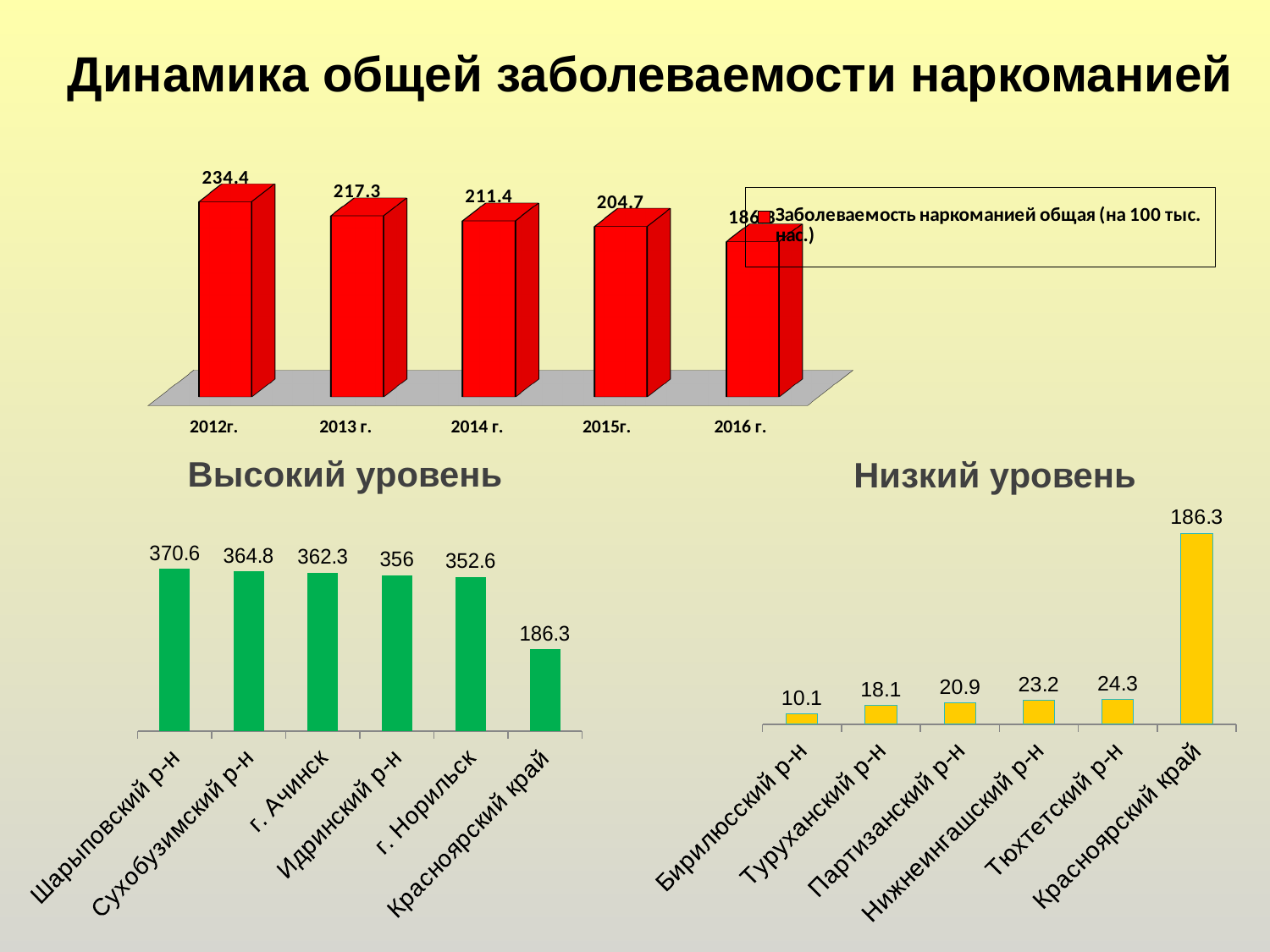
In the 'Низкий уровень' chart, what is the value for Нижнеингашский р-н? 23.2 In the 'Высокий уровень' chart, what is the difference between Шарыповский р-н and Красноярский край? 184.3 What type of chart is the 'Низкий уровень' chart? bar chart In the 'Высокий уровень' chart, which category has the highest value? Шарыповский р-н In the top chart (years 2012–2016), what is the value for 2012г.? 234.4 In the top chart (years 2012–2016), what is the value for 2015г.? 204.7 In the 'Высокий уровень' chart, what is the value for г. Ачинск? 362.3 In the top chart (years 2012–2016), do the values rise or fall from 2012 to 2016? fall In the top chart (years 2012–2016), how many years are plotted? 5 In the top chart (years 2012–2016), what is the difference between the 2013 г. and 2014 г. values? 5.9 In the 'Низкий уровень' chart, which is larger: Туруханский р-н or Тюхтетский р-н? Тюхтетский р-н In the 'Низкий уровень' chart, which category has the lowest value? Бирилюсский р-н